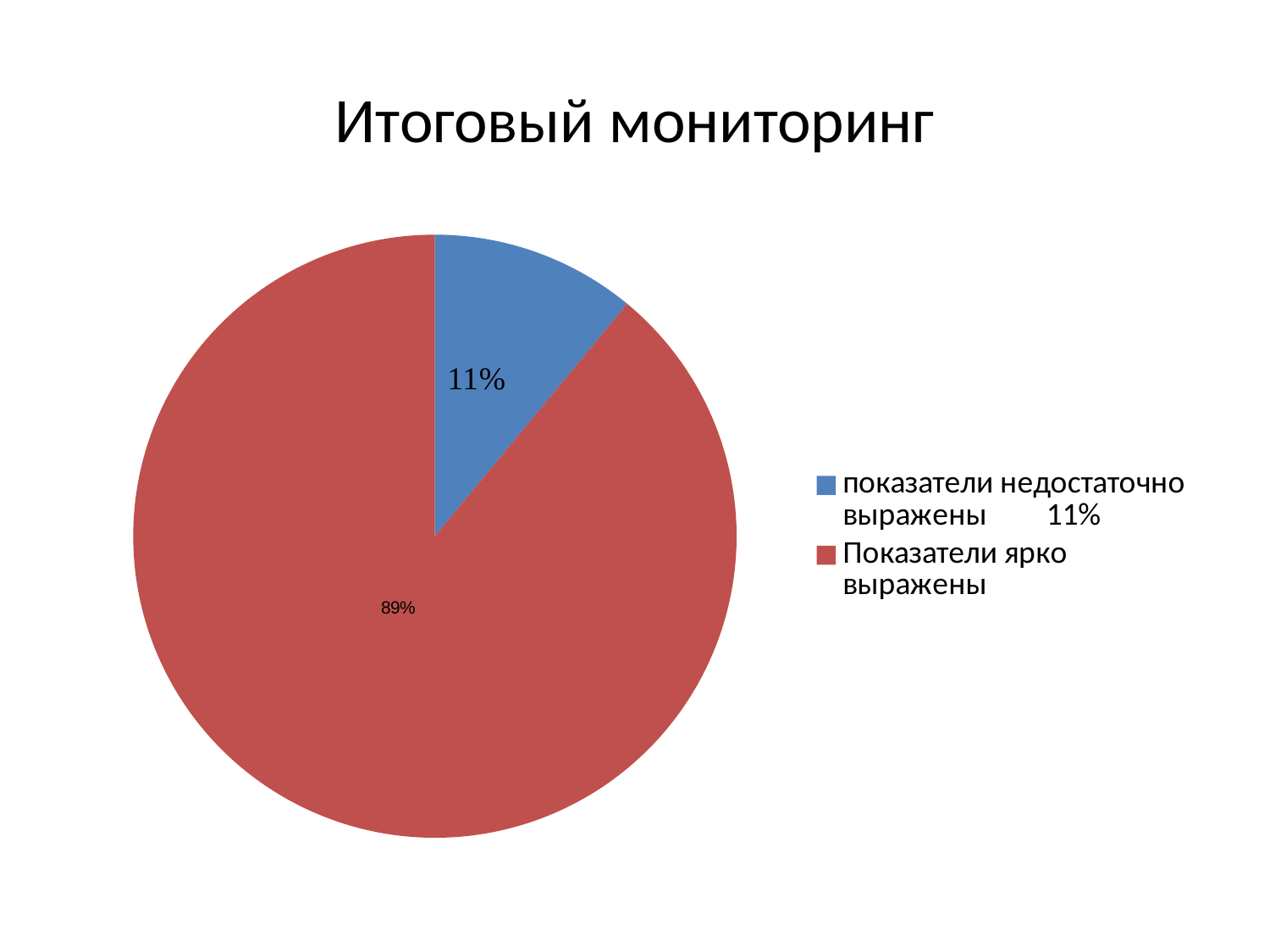
What is the difference between the shares of 'Показатели ярко выражены' and 'показатели недостаточно выражены'? 78% What is the title of the slide? Итоговый мониторинг Which slice is the largest in the pie chart? Показатели ярко выражены What kind of chart is shown on the slide? pie chart Which is larger: the share of 'показатели недостаточно выражены' or the share of 'Показатели ярко выражены'? Показатели ярко выражены What colour is the slice for 'Показатели ярко выражены'? red What share of the pie does the slice 'показатели недостаточно выражены' take? 11% What share of the pie does the slice 'Показатели ярко выражены' take? 89% How many entries does the legend list? 2 How many slices does the pie chart have? 2 Which slice is the smallest in the pie chart? показатели недостаточно выражены